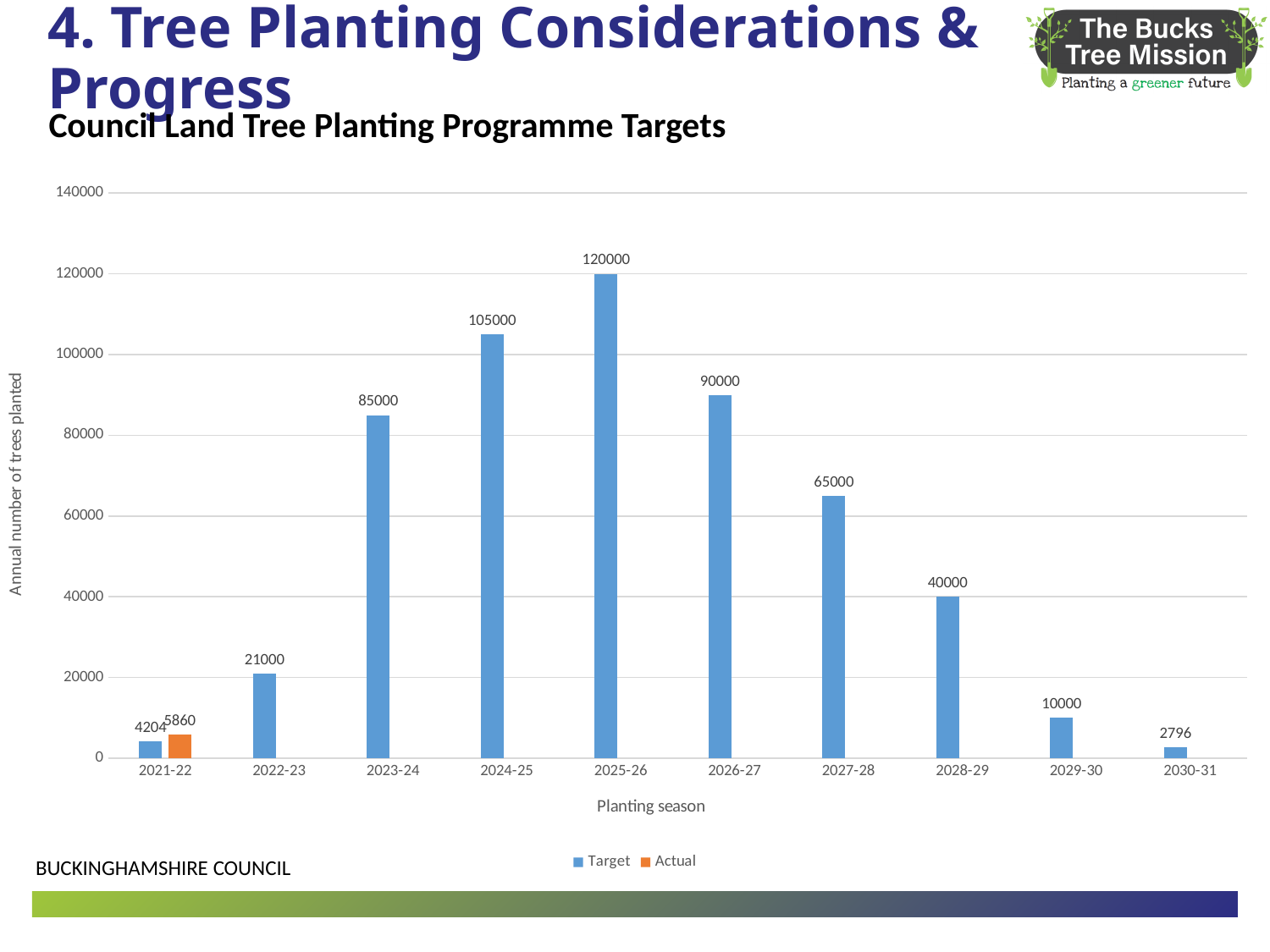
Which planting season has the lowest Target value? 2030-31 What is the Target value for the 2023-24 planting season? 85000 How many planting seasons are shown on the x axis? 10 What is the label of the y axis? Annual number of trees planted For 2021-22, which is larger, the Target or the Actual value? Actual What is the Target value for the 2025-26 planting season? 120000 Which planting season has the highest Target value? 2025-26 Do the Target values rise or fall from 2025-26 to 2030-31? Fall What is the Actual value for the 2021-22 planting season? 5860 How many series does the legend list? 2 What type of chart is shown on the slide? Bar chart What is the difference between the Target values for 2024-25 and 2026-27? 15000